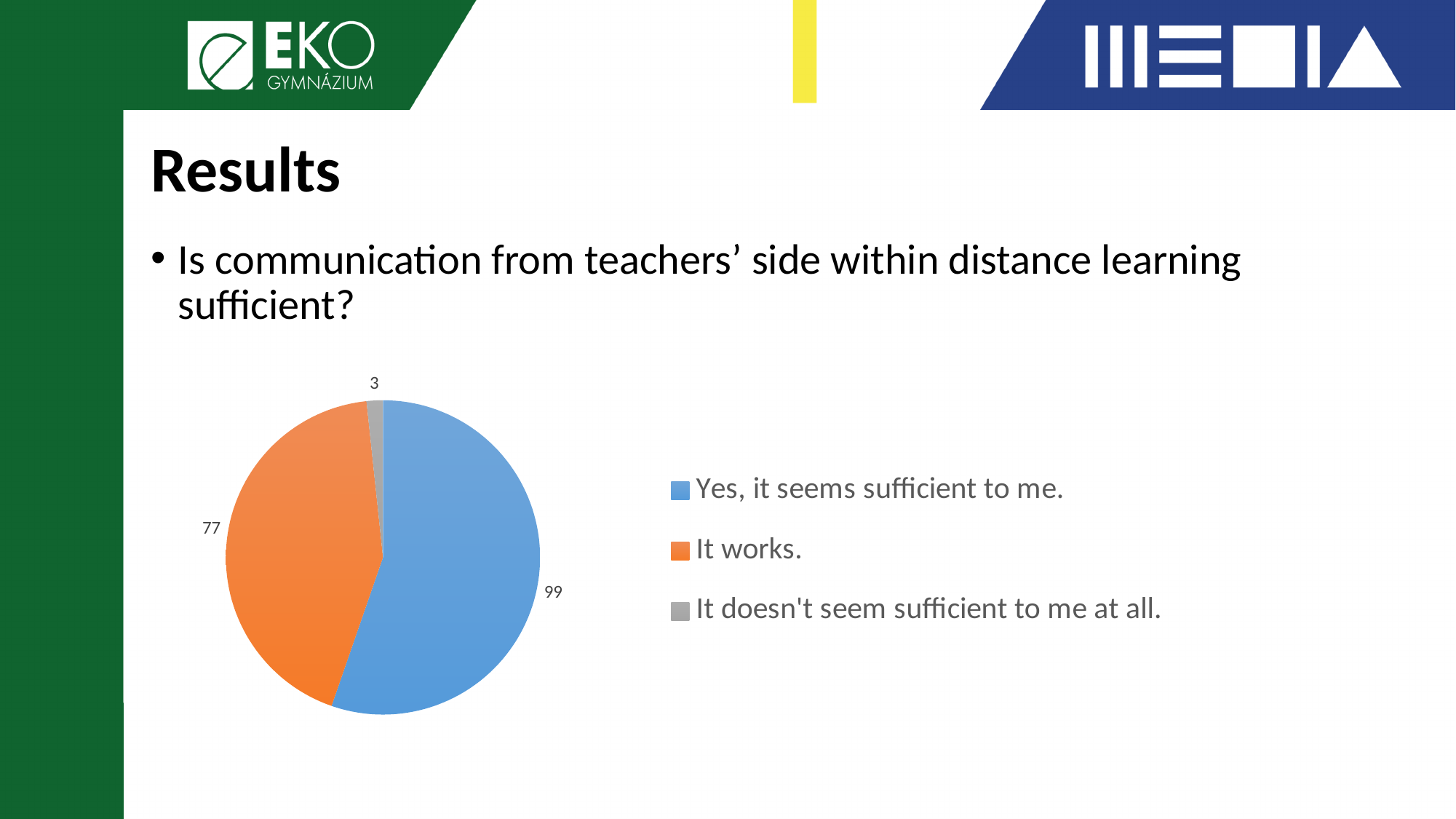
What kind of chart is shown on the slide? Pie chart How many slices does the pie chart have? 3 Which answer has the largest slice of the pie? Yes, it seems sufficient to me. Which answer has the smallest slice of the pie? It doesn't seem sufficient to me at all. How many respondents answered "It doesn't seem sufficient to me at all."? 3 What is the difference between the number of "Yes, it seems sufficient to me." responses and "It works." responses? 22 How many respondents answered "It works."? 77 How many entries does the legend list? 3 How many respondents answered "Yes, it seems sufficient to me."? 99 What is the total number of responses shown in the pie chart? 179 Which colour represents "It works." in the pie chart? Orange Which received more responses: "It works." or "It doesn't seem sufficient to me at all."? It works.